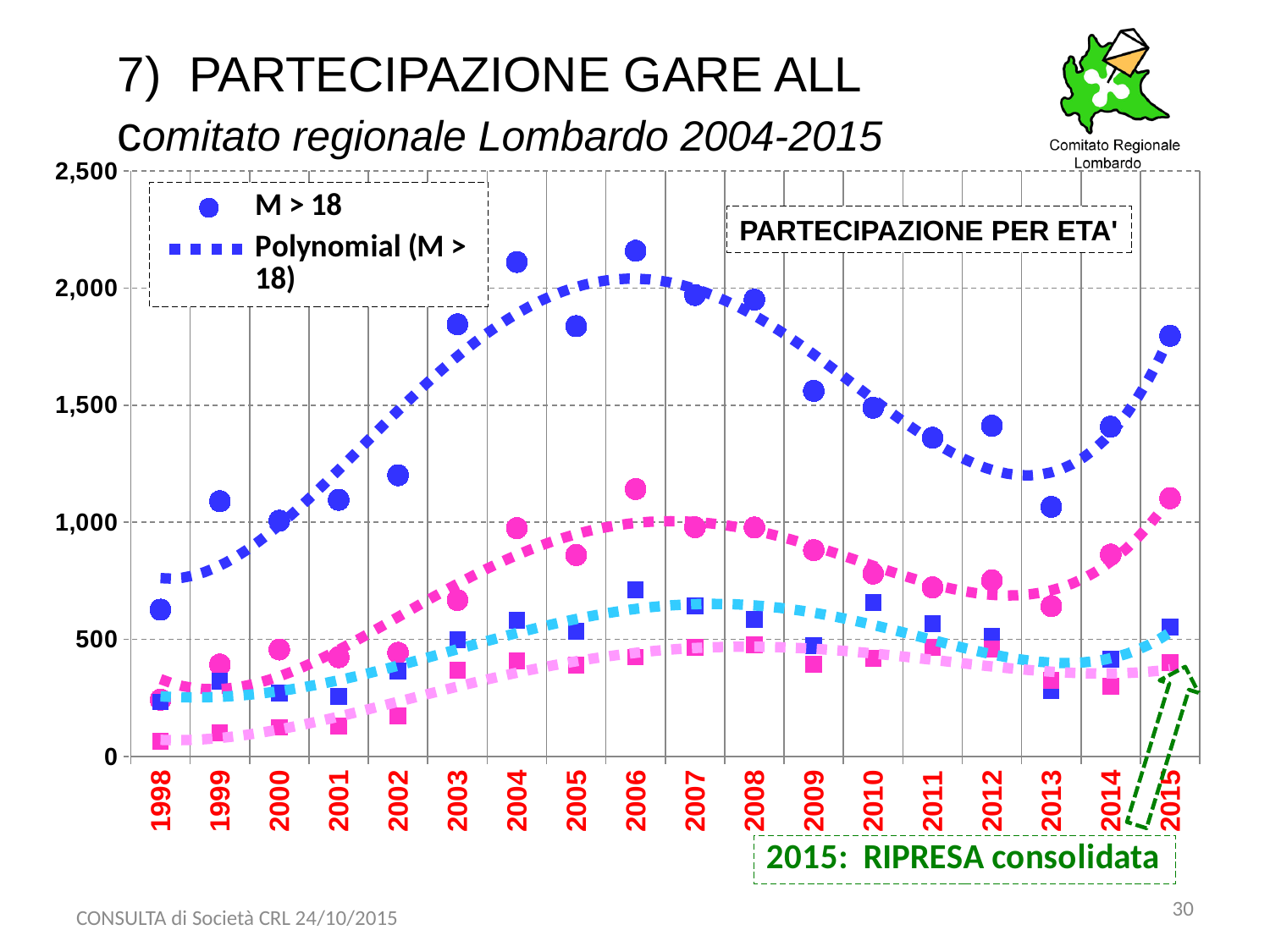
Is the value for M > 18 in 1998 greater or less than 1,000? less Which year has the lowest value for the M > 18 series? 1998 What text appears in the box in the upper right of the plot area? PARTECIPAZIONE PER ETA' Does the M > 18 series rise or fall from 2013 to 2015? rise What kind of chart is shown on the slide? scatter chart Is the value for M > 18 in 2004 greater or less than 2,000? greater Which is larger for the M > 18 series: the value in 1998 or the value in 2015? 2015 Which is larger for the M > 18 series: the value in 2004 or the value in 2013? 2004 Is the value for M > 18 in 2015 greater or less than 1,500? greater How many years are plotted along the x axis? 18 How many series does the legend list? 2